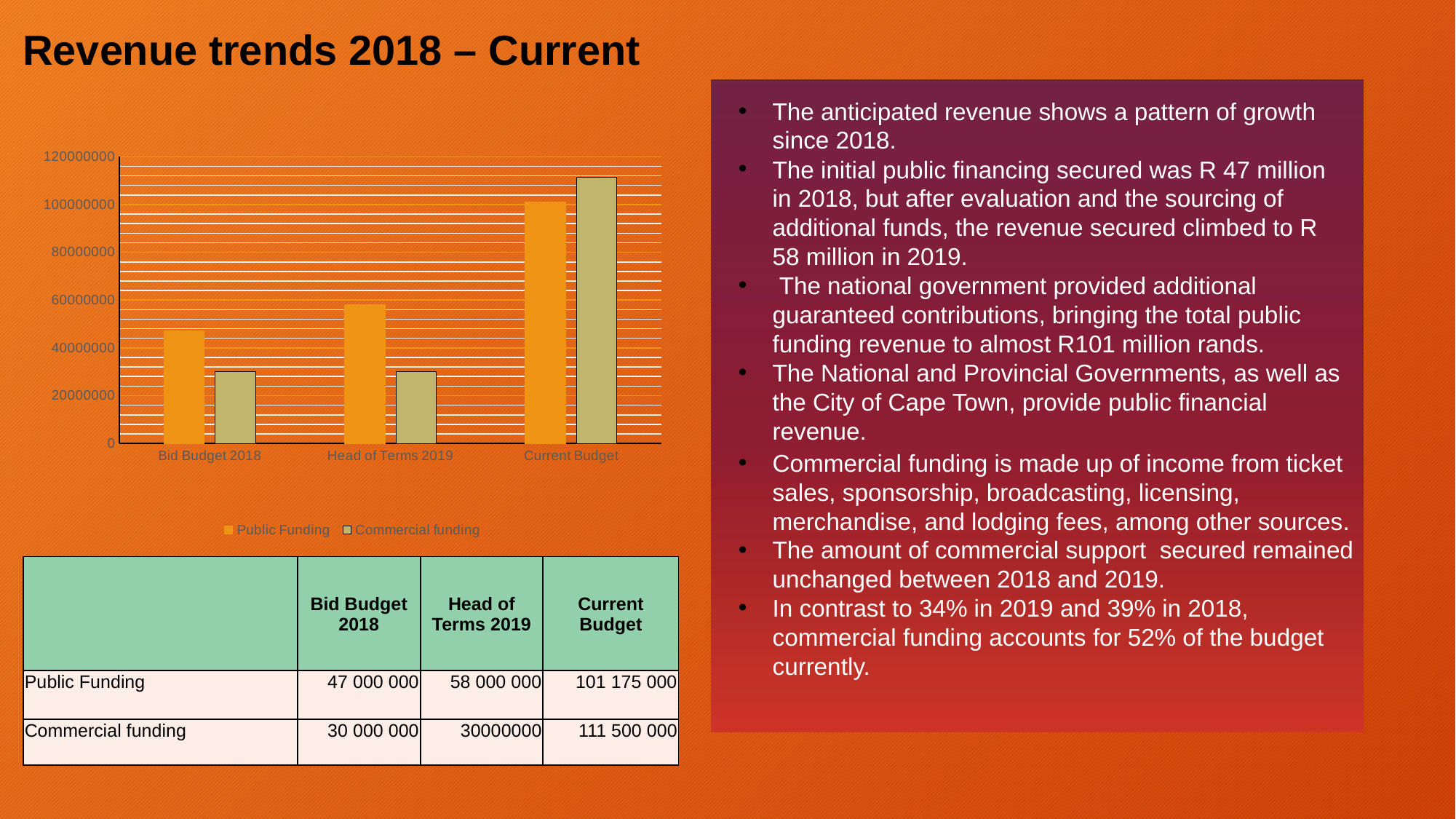
Is the Public Funding value for Current Budget greater or less than 100000000? greater How many series does the chart legend list? 2 How many categories are shown on the x axis of the chart? 3 Does Public Funding rise or fall across the categories from Bid Budget 2018 to Current Budget? rise Is the Commercial funding value for Bid Budget 2018 greater or less than 40000000? less What is the Public Funding value for Head of Terms 2019? 58 000 000 Which category has the lowest Public Funding value? Bid Budget 2018 What is the Public Funding value for Bid Budget 2018? 47 000 000 For Current Budget, which is larger: Public Funding or Commercial funding? Commercial funding What kind of chart is shown on the slide? bar chart Which category has the highest Public Funding value? Current Budget What is the Commercial funding value for Current Budget? 111 500 000